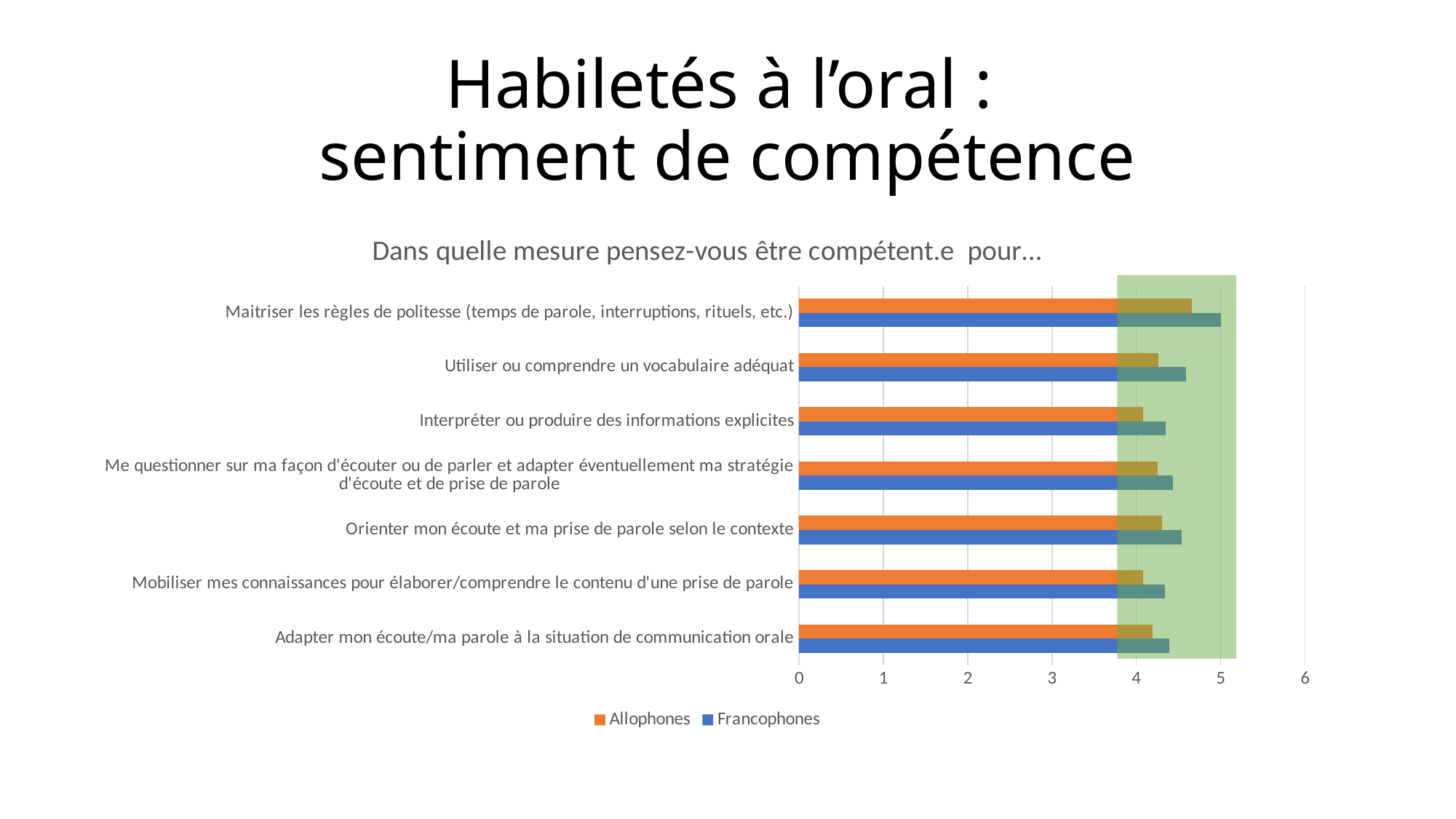
Is the Allophones value for 'Maitriser les règles de politesse' greater or less than 5? less How many categories (skills) are plotted on the chart? 7 Which category has the highest value for Francophones? Maitriser les règles de politesse (temps de parole, interruptions, rituels, etc.) For 'Utiliser ou comprendre un vocabulaire adéquat', which series has the larger value, Allophones or Francophones? Francophones Which colour represents the Allophones series? orange Which category has the highest value for Allophones? Maitriser les règles de politesse (temps de parole, interruptions, rituels, etc.) Is the Allophones value for 'Interpréter ou produire des informations explicites' greater or less than 3? greater What kind of chart is shown on the slide? bar chart How many series does the legend list? 2 Is the Francophones value for 'Adapter mon écoute/ma parole à la situation de communication orale' greater or less than 4? greater For 'Maitriser les règles de politesse', which series has the larger value, Allophones or Francophones? Francophones What is the title of the chart? Dans quelle mesure pensez-vous être compétent.e pour…